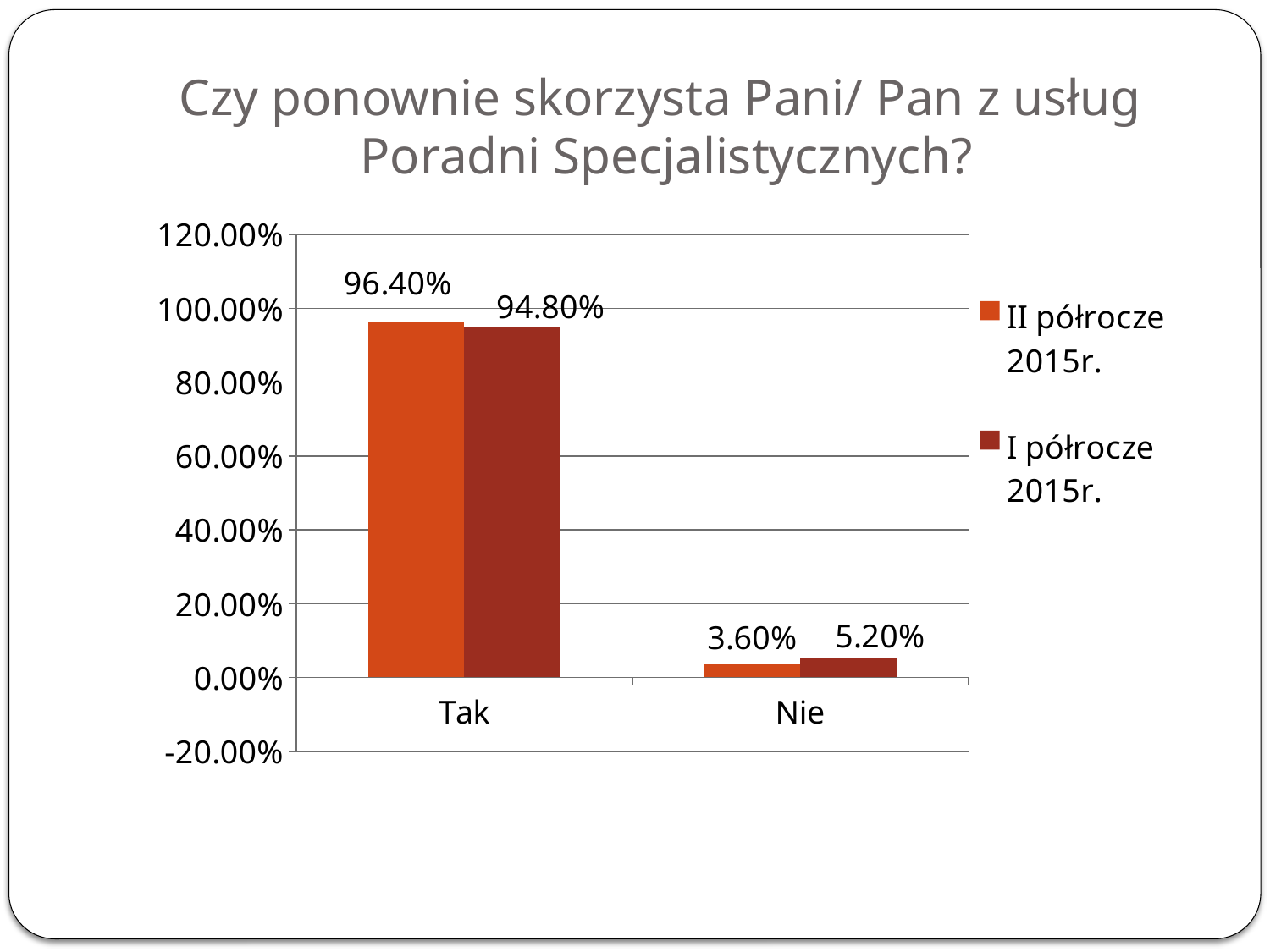
Which category has the highest value in the "II półrocze 2015r." series? Tak How many categories are shown on the x axis? 2 What kind of chart is shown on the slide? Bar chart What is the difference between the "Tak" values for "II półrocze 2015r." and "I półrocze 2015r."? 1.60% For "Nie", which series has the larger value: "II półrocze 2015r." or "I półrocze 2015r."? I półrocze 2015r. What is the value for "Nie" in the "II półrocze 2015r." series? 3.60% What is the title of the chart? Czy ponownie skorzysta Pani/ Pan z usług Poradni Specjalistycznych? What is the value for "Tak" in the "I półrocze 2015r." series? 94.80% Which category has the lowest value in the "I półrocze 2015r." series? Nie How many series does the legend list? 2 What is the value for "Tak" in the "II półrocze 2015r." series? 96.40% What is the value for "Nie" in the "I półrocze 2015r." series? 5.20%